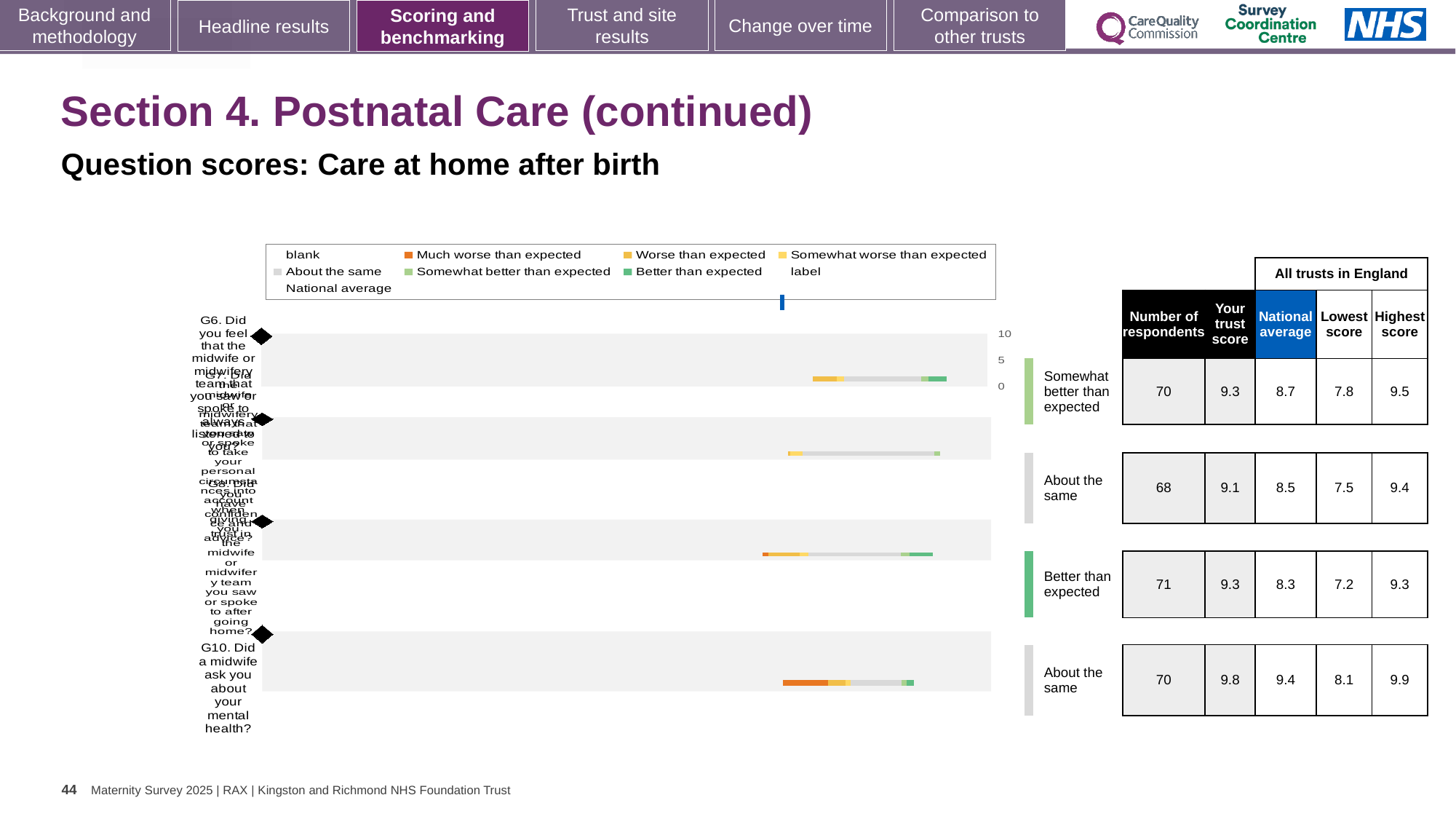
In the table beside the chart, what is the 'Your trust score' for G10 (Did a midwife ask you about your mental health?)? 9.8 In the table beside the chart, what is the highest score across all trusts in England for G10 (Did a midwife ask you about your mental health?)? 9.9 What kind of chart is shown on the slide? bar chart How many question bars are plotted in the chart? 4 For G10, how much higher is the trust score than the national average in the table beside the chart? 0.4 In the table beside the chart, what is the lowest score across all trusts in England for the first question row (G6)? 7.8 What colour does the legend use for 'Much worse than expected'? orange In the table beside the chart, what is the number of respondents for G10 (Did a midwife ask you about your mental health?)? 70 In the table beside the chart, what is the national average for G10 (Did a midwife ask you about your mental health?)? 9.4 What colour does the legend use for 'Better than expected'? green For G10, which is larger in the table beside the chart: the trust score or the national average? the trust score Which question row has the highest 'Your trust score' in the table beside the chart? G10 (Did a midwife ask you about your mental health?)